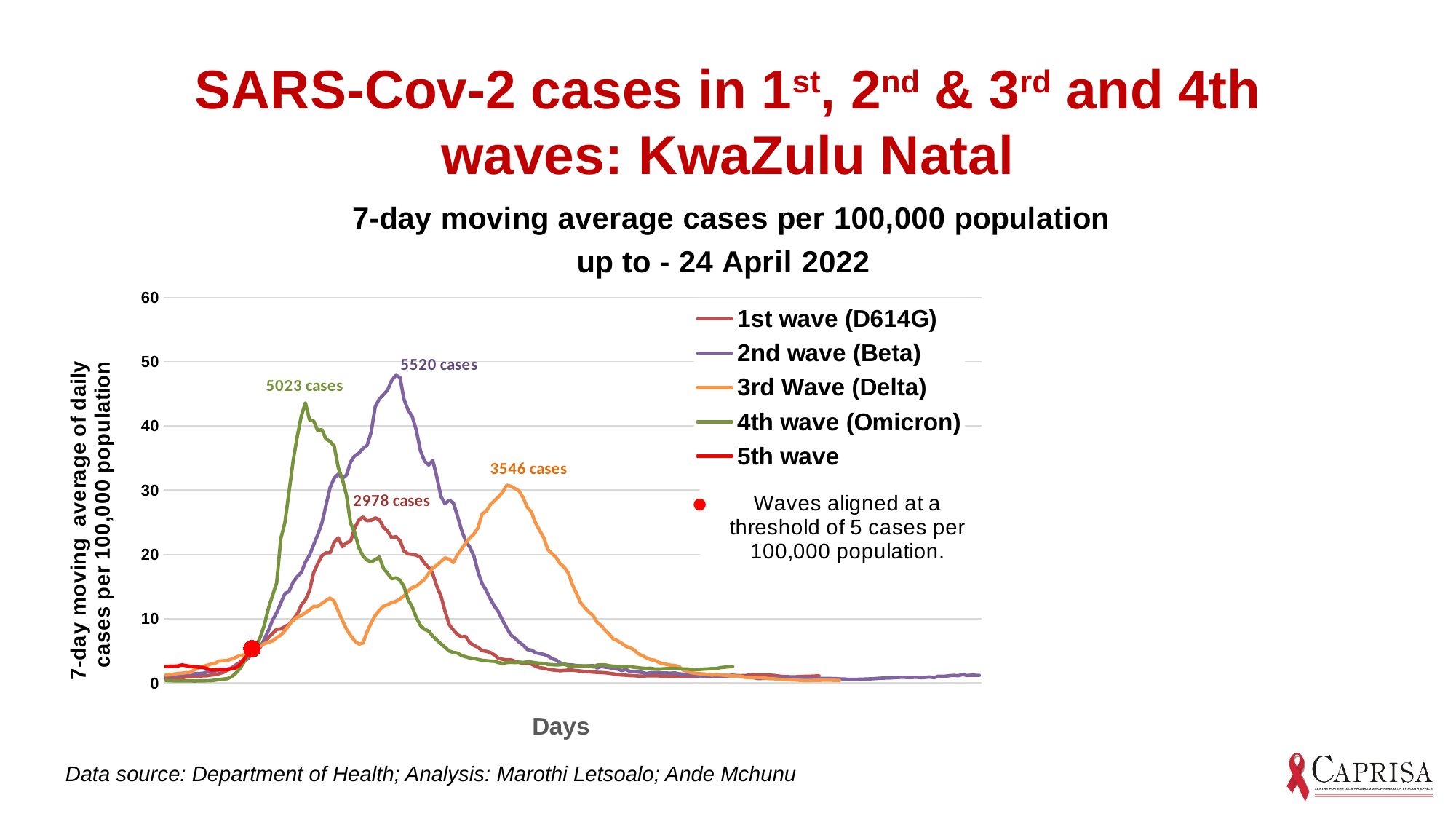
How many series does the legend list? 5 Is the peak of the 3rd Wave (Delta) line greater or less than 40 cases per 100,000 population? less How many cases are labelled at the peak of the 4th wave (Omicron)? 5023 cases How many cases are labelled at the peak of the 1st wave (D614G)? 2978 cases At what threshold are the waves aligned, according to the note on the chart? 5 cases per 100,000 population Which wave reaches the highest peak 7-day moving average of cases per 100,000 population? 2nd wave (Beta) What is the difference between the labelled peak case counts of the 2nd wave (5520 cases) and the 4th wave (5023 cases)? 497 cases How many cases are labelled at the peak of the 3rd Wave (Delta)? 3546 cases How many cases are labelled at the peak of the 2nd wave (Beta)? 5520 cases Which peaks higher on the chart, the 4th wave (Omicron) line or the 3rd Wave (Delta) line? 4th wave (Omicron) Among the four waves with labelled peak case counts, which has the lowest peak 7-day moving average? 1st wave (D614G) What kind of chart is shown on the slide? line chart